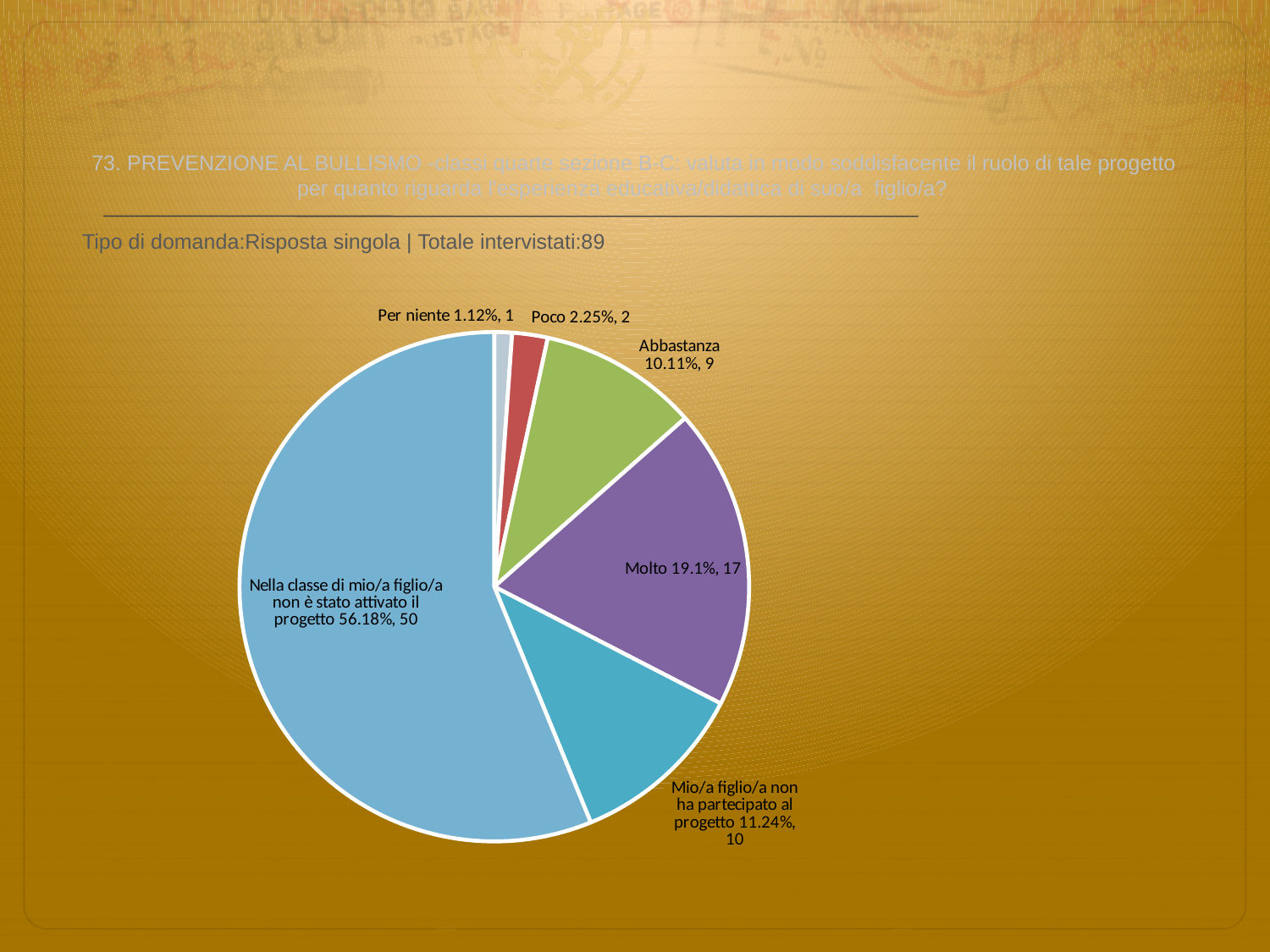
What percentage share does the "Nella classe di mio/a figlio/a non è stato attivato il progetto" slice have? 56.18% What is the percentage share of the "Per niente" slice? 1.12% What percentage share does the "Molto" slice have? 19.1% What is the count for "Poco"? 2 What is the difference in count between "Molto" and "Abbastanza"? 8 How many respondents answered "Abbastanza"? 9 Which has a larger count, "Mio/a figlio/a non ha partecipato al progetto" or "Abbastanza"? Mio/a figlio/a non ha partecipato al progetto How many slices does the pie chart have? 6 According to the text above the chart, what is the total number of respondents (Totale intervistati)? 89 Which category has the largest slice of the pie? Nella classe di mio/a figlio/a non è stato attivato il progetto What kind of chart is shown on the slide? pie chart Which category has the smallest slice of the pie? Per niente